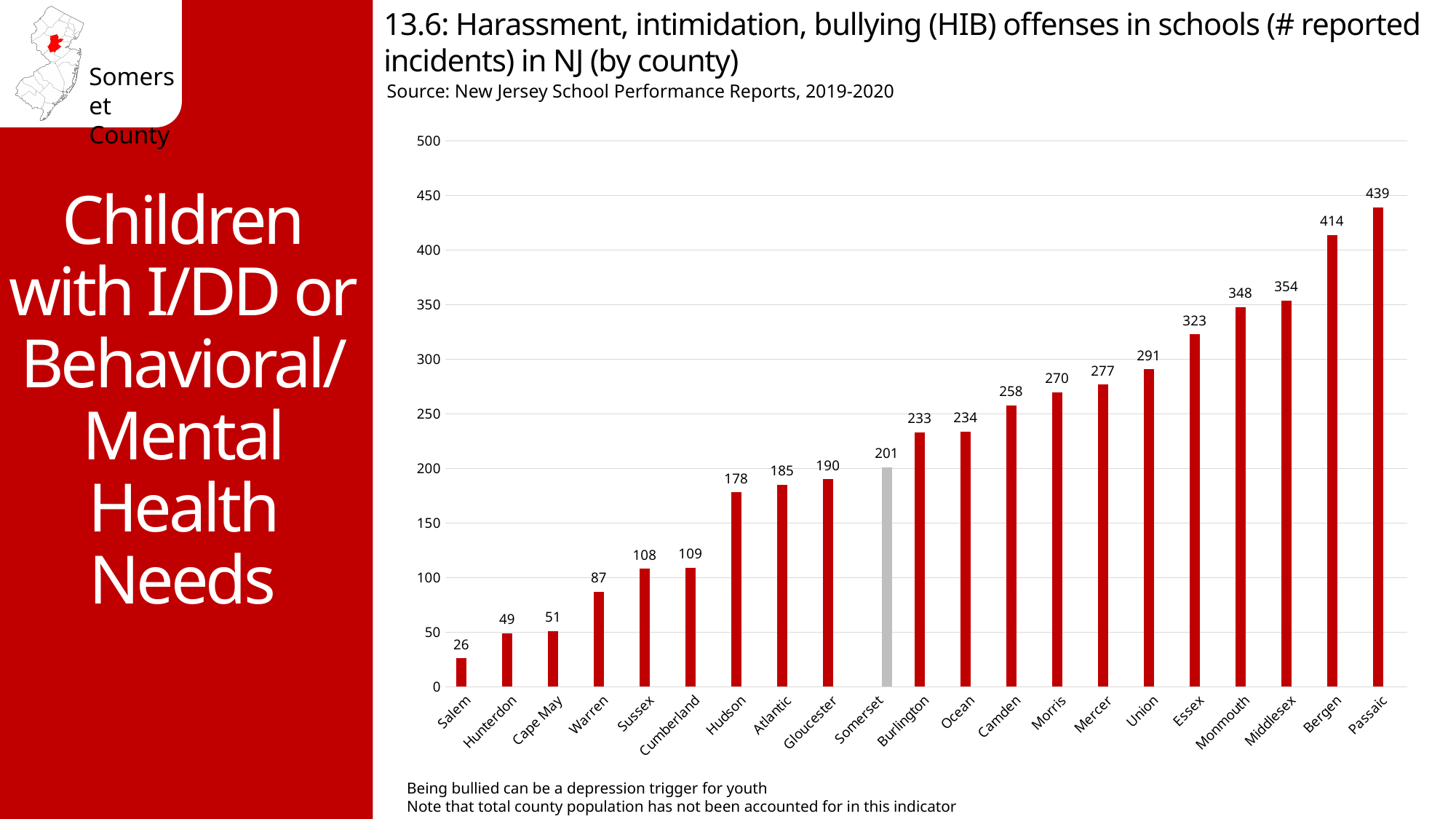
How many reported HIB incidents does the chart show for Somerset? 201 What kind of chart is shown on the slide? bar chart What is the value shown for Hudson? 178 Which county has the lowest number of reported HIB incidents? Salem Do the values rise or fall moving from left to right along the x axis? rise How many counties are shown on the x axis? 21 Which county's bar is coloured grey instead of red? Somerset Which has more reported incidents, Essex or Union? Essex What is the difference between the values for Passaic and Bergen? 25 Is the value for Monmouth greater or less than 300? greater Which county has the highest number of reported HIB incidents? Passaic What is the difference between the values for Somerset and Salem? 175